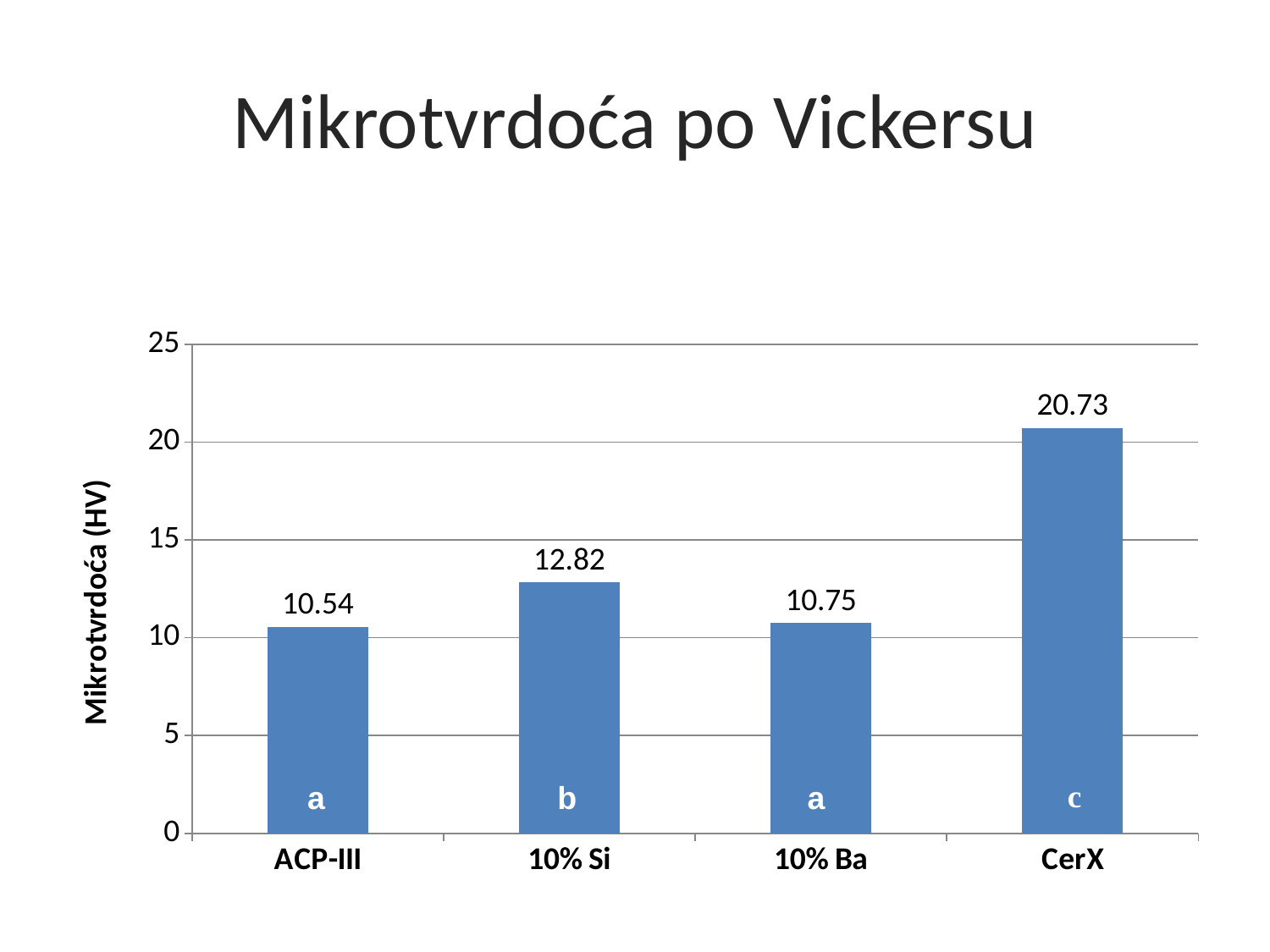
Which material has the highest microhardness? CerX What is the microhardness value for ACP-III? 10.54 What is the difference in microhardness between 10% Ba and ACP-III? 0.21 What is the microhardness value for 10% Si? 12.82 What is the microhardness value for 10% Ba? 10.75 Is the value for CerX greater or less than 20? greater What is the microhardness value for CerX? 20.73 Which material has the lowest microhardness? ACP-III What type of chart is shown on the slide? Bar chart How many materials are shown on the chart? 4 What is the difference in microhardness between CerX and 10% Si? 7.91 Which has a higher microhardness, 10% Si or 10% Ba? 10% Si